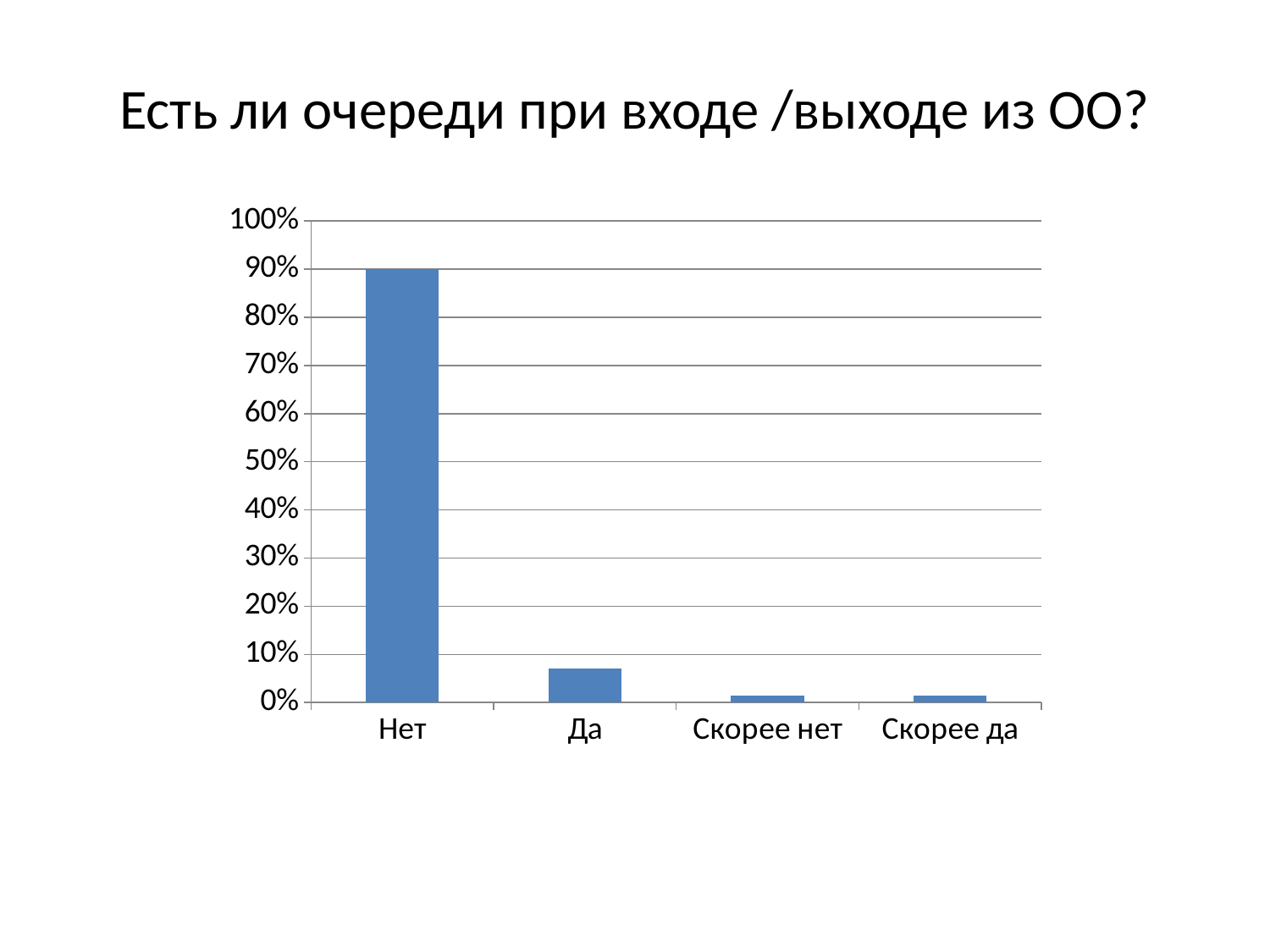
Which is larger, the value for Да or the value for Скорее да? Да Is the value for Нет greater or less than 80%? greater What is the highest value shown on the y axis? 100% What is the value for Нет? 90% Is the value for Скорее нет greater or less than 10%? less Which category has the highest value? Нет Which is larger, the value for Нет or the value for Да? Нет Is the value for Да greater or less than 10%? less How many categories are shown on the x axis of the chart? 4 What kind of chart is shown on the slide? bar chart What is the title of the chart? Есть ли очереди при входе /выходе из ОО?